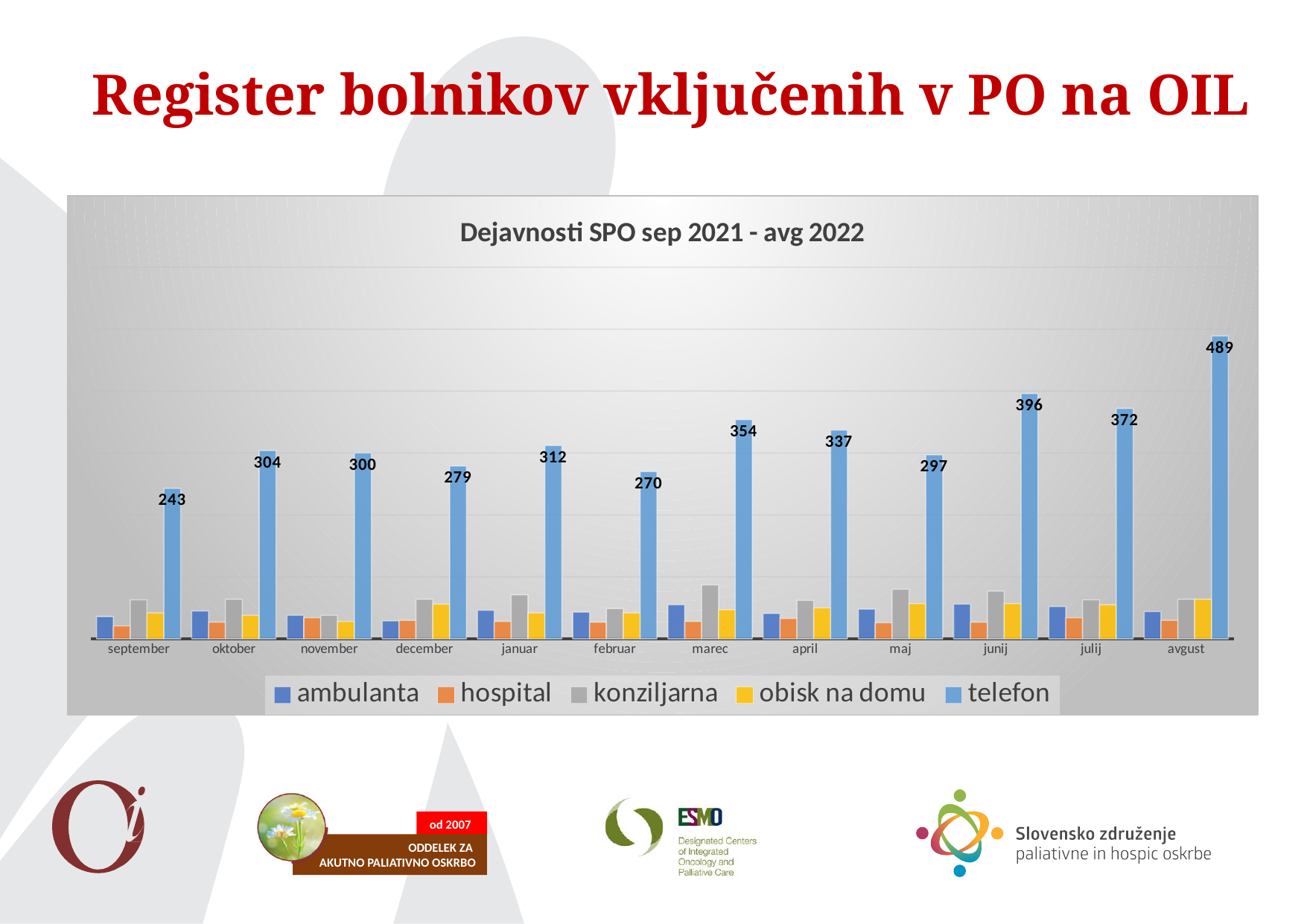
What is the difference between the telefon values for avgust and september? 246 Which month has the highest telefon value? avgust What is the title of the chart? Dejavnosti SPO sep 2021 - avg 2022 How many series does the legend list? 5 Which series is shown in yellow in the legend? obisk na domu How many months are shown on the x axis? 12 What kind of chart is shown on the slide? bar chart What is the telefon value for september? 243 What is the telefon value for marec? 354 Which is larger, the telefon value for junij or for julij? junij Which month has the lowest telefon value? september What is the telefon value for avgust? 489